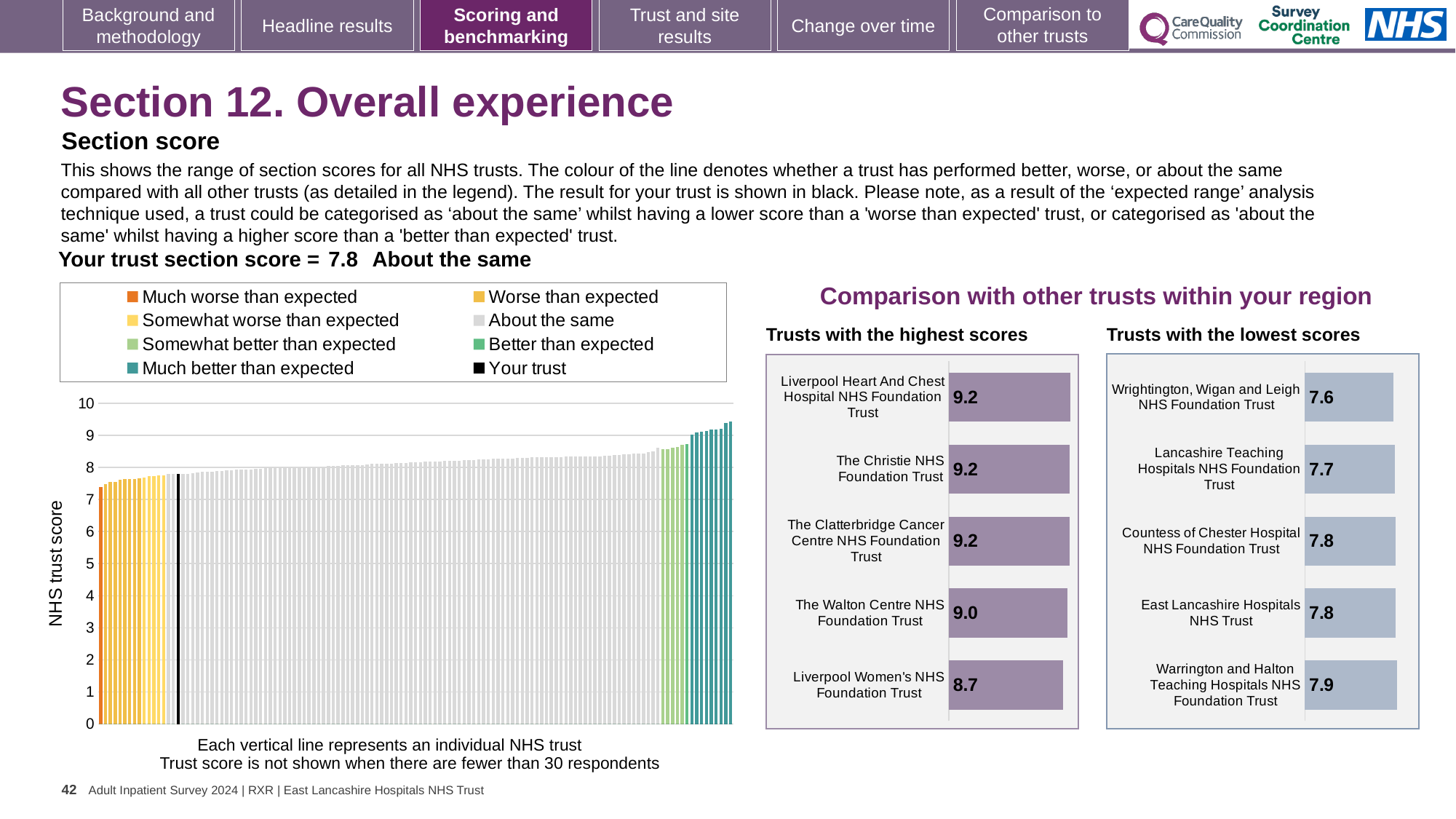
In the 'Trusts with the highest scores' chart, what is the score for The Walton Centre NHS Foundation Trust? 9.0 In the 'Trusts with the lowest scores' chart, what is the difference between the scores of Warrington and Halton Teaching Hospitals NHS Foundation Trust and Wrightington, Wigan and Leigh NHS Foundation Trust? 0.3 In the 'Trusts with the lowest scores' chart, what is the score for Wrightington, Wigan and Leigh NHS Foundation Trust? 7.6 In the 'Trusts with the highest scores' chart, which trust has the lowest score? Liverpool Women's NHS Foundation Trust In the 'Trusts with the lowest scores' chart, what is the score for Warrington and Halton Teaching Hospitals NHS Foundation Trust? 7.9 In the large chart on the left showing NHS trust scores, do the values rise or fall from left to right along the x axis? rise In the 'Trusts with the highest scores' chart, what is the score for Liverpool Women's NHS Foundation Trust? 8.7 In the 'Trusts with the highest scores' chart, what is the difference between the scores of Liverpool Heart And Chest Hospital NHS Foundation Trust and Liverpool Women's NHS Foundation Trust? 0.5 In the 'Trusts with the highest scores' chart, how many trusts are shown? 5 In the large chart on the left showing NHS trust scores, how many entries does the legend list? 8 In the 'Trusts with the lowest scores' chart, which trust has the highest score? Warrington and Halton Teaching Hospitals NHS Foundation Trust In the 'Trusts with the lowest scores' chart, which is larger: the score for Lancashire Teaching Hospitals NHS Foundation Trust or the score for East Lancashire Hospitals NHS Trust? East Lancashire Hospitals NHS Trust